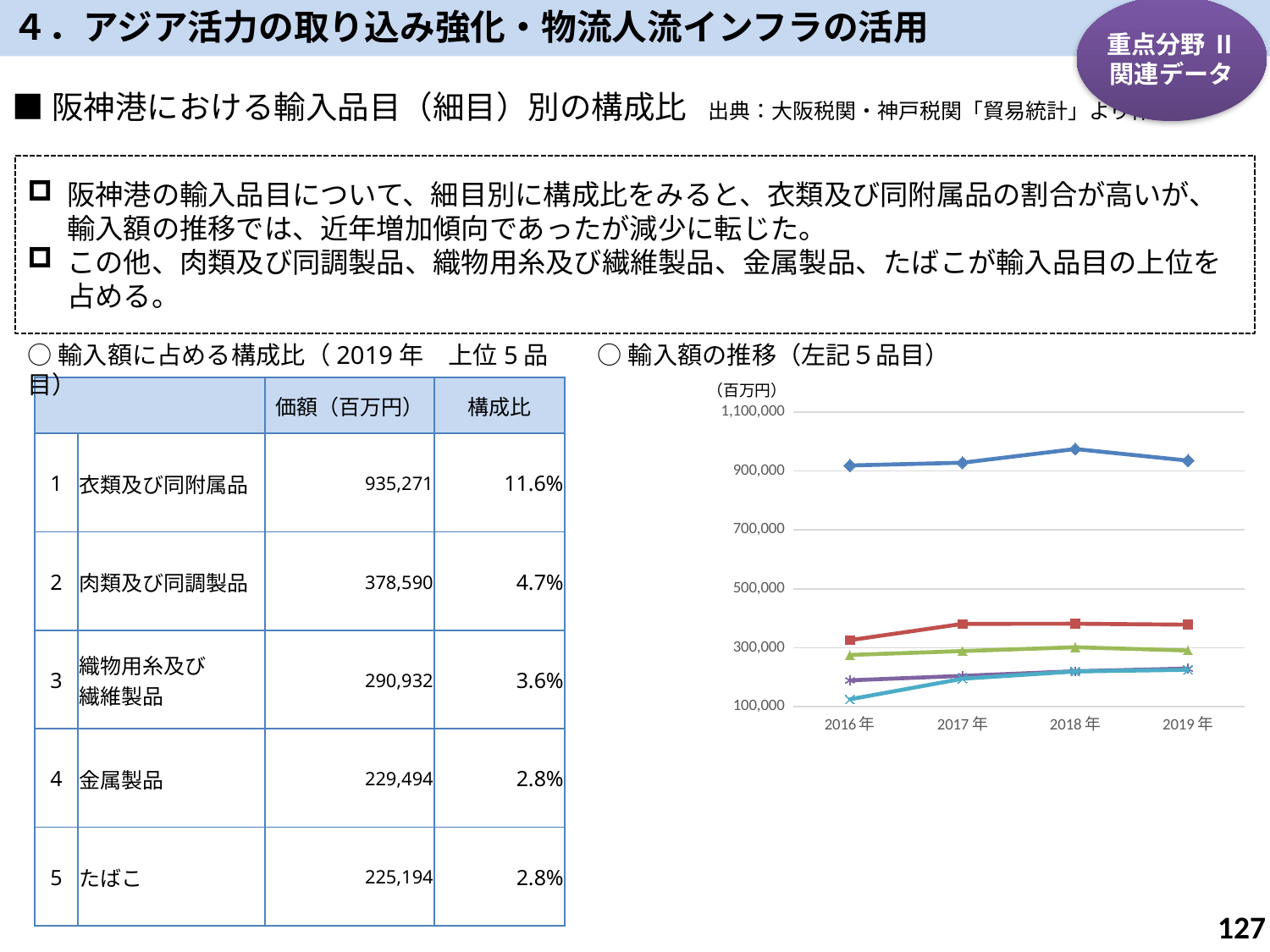
In the line chart 「輸入額の推移（左記５品目）」, which line is the lowest in 2016年? the light blue (cyan) line In the line chart 「輸入額の推移（左記５品目）」, is the value of the blue line in 2018年 greater or less than 900,000? greater How many lines are plotted in the line chart 「輸入額の推移（左記５品目）」? 5 In the line chart 「輸入額の推移（左記５品目）」, does the light blue (cyan) line rise or fall from 2016年 to 2019年? rise What unit is shown at the top of the y axis of the line chart 「輸入額の推移（左記５品目）」? 百万円 In the line chart 「輸入額の推移（左記５品目）」, which line is the highest across all years? the blue line In the line chart 「輸入額の推移（左記５品目）」, is the value of the red line in 2017年 greater or less than 300,000? greater In the line chart 「輸入額の推移（左記５品目）」, is the value of the light blue (cyan) line in 2016年 greater or less than 300,000? less What kind of chart is shown on the right side of the slide under 「輸入額の推移（左記５品目）」? line chart In the line chart 「輸入額の推移（左記５品目）」, which is larger in 2019年, the blue line or the red line? the blue line How many years are shown on the x axis of the line chart 「輸入額の推移（左記５品目）」? 4 In the line chart 「輸入額の推移（左記５品目）」, does the blue line rise or fall from 2018年 to 2019年? fall